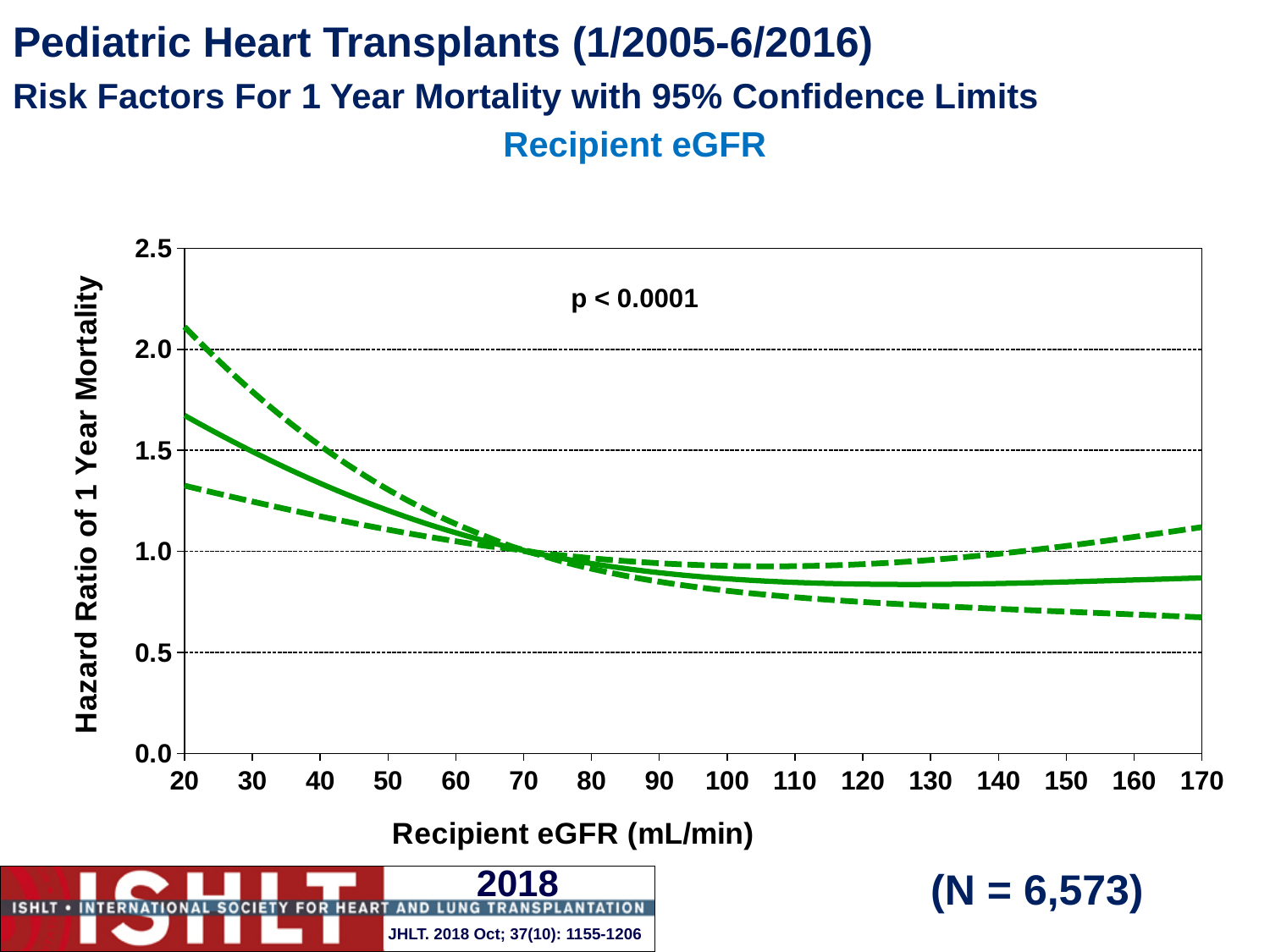
What is the sample size (N) shown on the slide? N = 6,573 Is the value of the solid line at a Recipient eGFR of 20 mL/min greater or less than 1.5? greater Is the value of the lower dashed line at a Recipient eGFR of 170 mL/min greater or less than 0.5? greater Is the value of the solid line at a Recipient eGFR of 170 mL/min greater or less than 1.0? less Is the value of the solid line higher at a Recipient eGFR of 20 mL/min or at 120 mL/min? 20 mL/min What p-value is shown on the chart? p < 0.0001 Does the solid line rise or fall as Recipient eGFR increases from 20 to 70 mL/min? falls What kind of chart is shown on the slide? line chart How many lines are plotted on the chart? 3